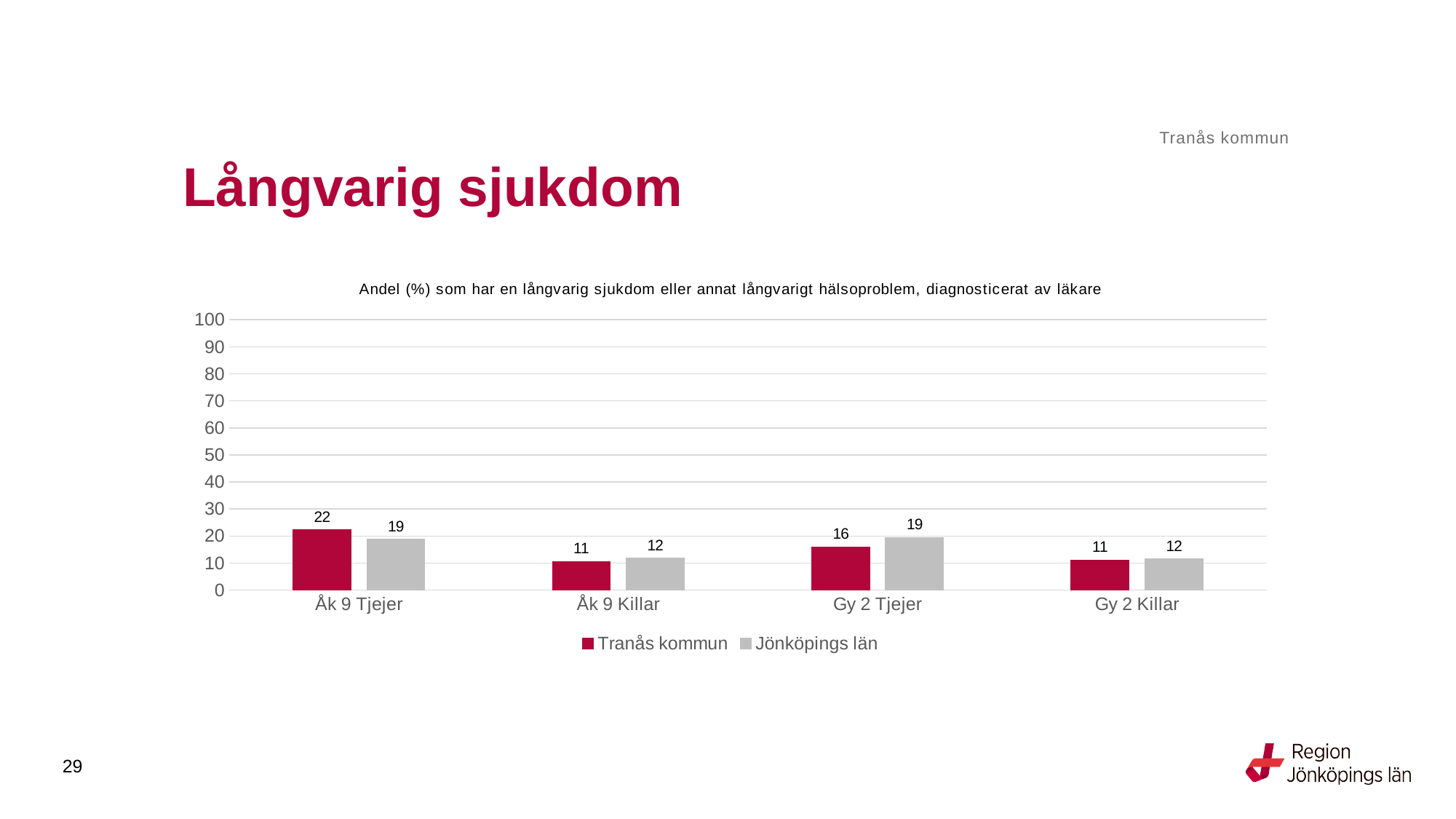
How many categories are shown on the x axis? 4 Which category has the lowest value for Jönköpings län? Åk 9 Killar and Gy 2 Killar (both 12) Which category has the highest value for Tranås kommun? Åk 9 Tjejer What is the difference between Tranås kommun and Jönköpings län in the Åk 9 Tjejer category? 3 What is the title of the chart? Andel (%) som har en långvarig sjukdom eller annat långvarigt hälsoproblem, diagnosticerat av läkare What is the value for Tranås kommun in the Gy 2 Killar category? 11 Which is larger in the Gy 2 Tjejer category, Tranås kommun or Jönköpings län? Jönköpings län What is the value for Tranås kommun in the Åk 9 Tjejer category? 22 What kind of chart is shown on the slide? Bar chart How many series does the legend list? 2 What is the difference between Jönköpings län and Tranås kommun in the Gy 2 Tjejer category? 3 What is the value for Jönköpings län in the Gy 2 Tjejer category? 19